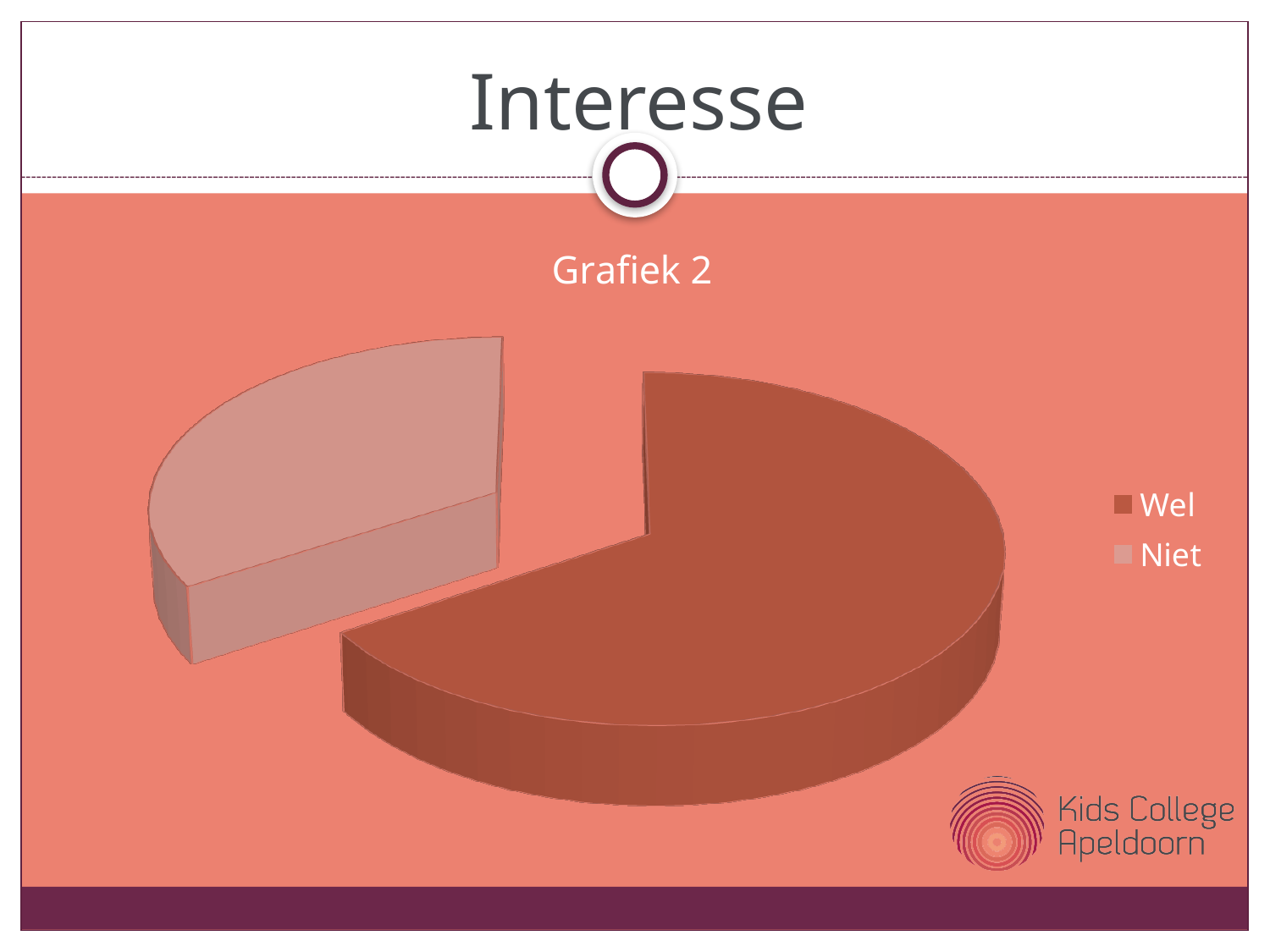
Which category has the smallest slice of the pie? Niet How many slices does the pie chart have? 2 Which category has the largest slice of the pie? Wel What is the title of the chart? Grafiek 2 How many entries does the legend list? 2 Which legend entry is shown in the lighter colour? Niet What kind of chart is shown on the slide? pie chart Which slice is larger, Wel or Niet? Wel